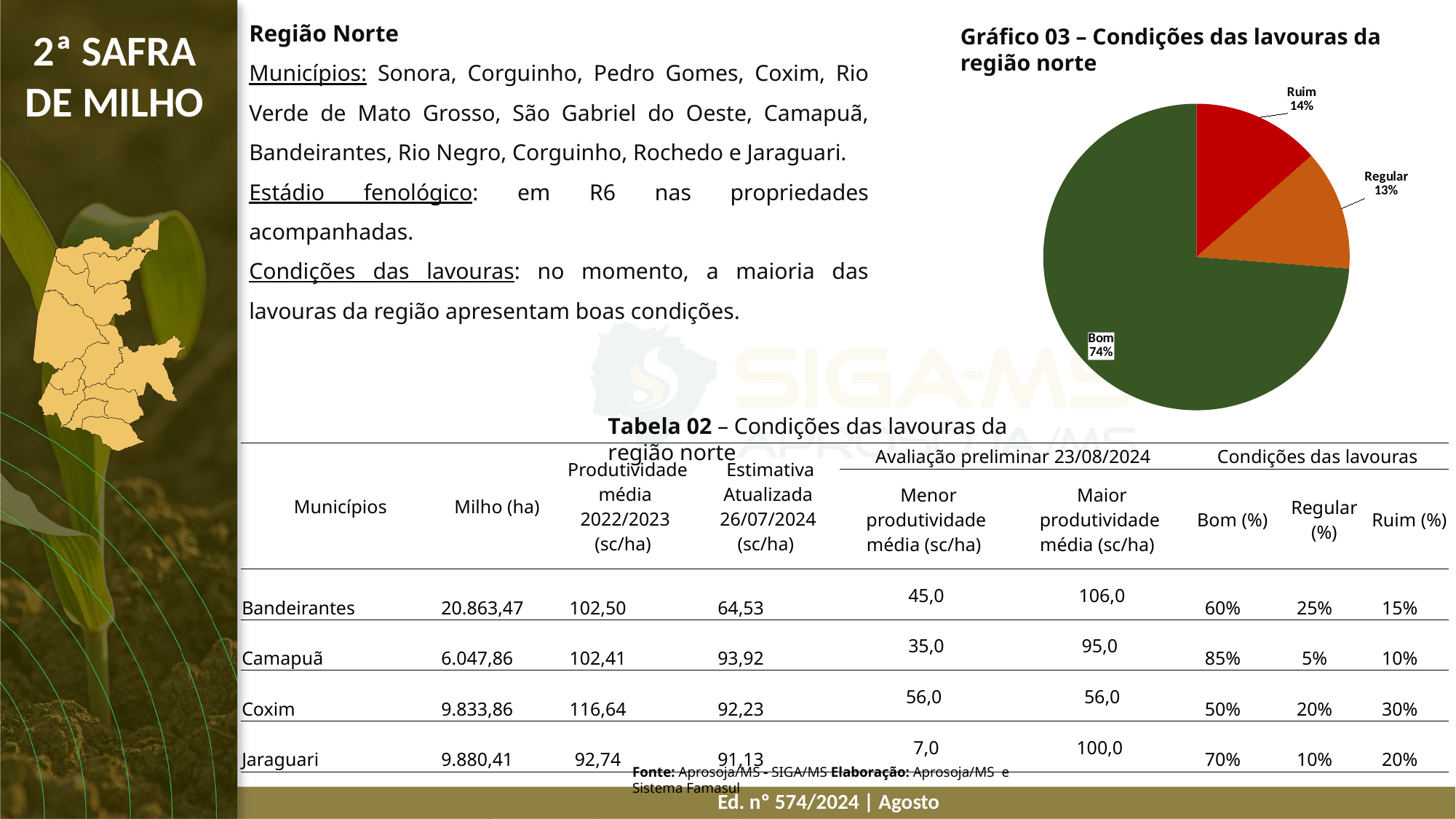
Which category has the largest slice in Gráfico 03? Bom In Gráfico 03, what percentage is shown for 'Ruim'? 14% What is the title of the pie chart on the slide? Gráfico 03 – Condições das lavouras da região norte In Gráfico 03, what percentage is shown for 'Regular'? 13% What kind of chart is Gráfico 03? pie chart In Gráfico 03, what colour is the 'Bom' slice? dark green Which category has the smallest slice in Gráfico 03? Regular In Gráfico 03, what is the difference in percentage points between 'Ruim' and 'Regular'? 1 In Gráfico 03, what share of the crops is in the 'Bom' condition? 74% How many slices does the pie chart in Gráfico 03 have? 3 In Gráfico 03, which is larger, 'Ruim' or 'Regular'? Ruim In Gráfico 03, how many percentage points larger is 'Bom' than 'Ruim'? 60